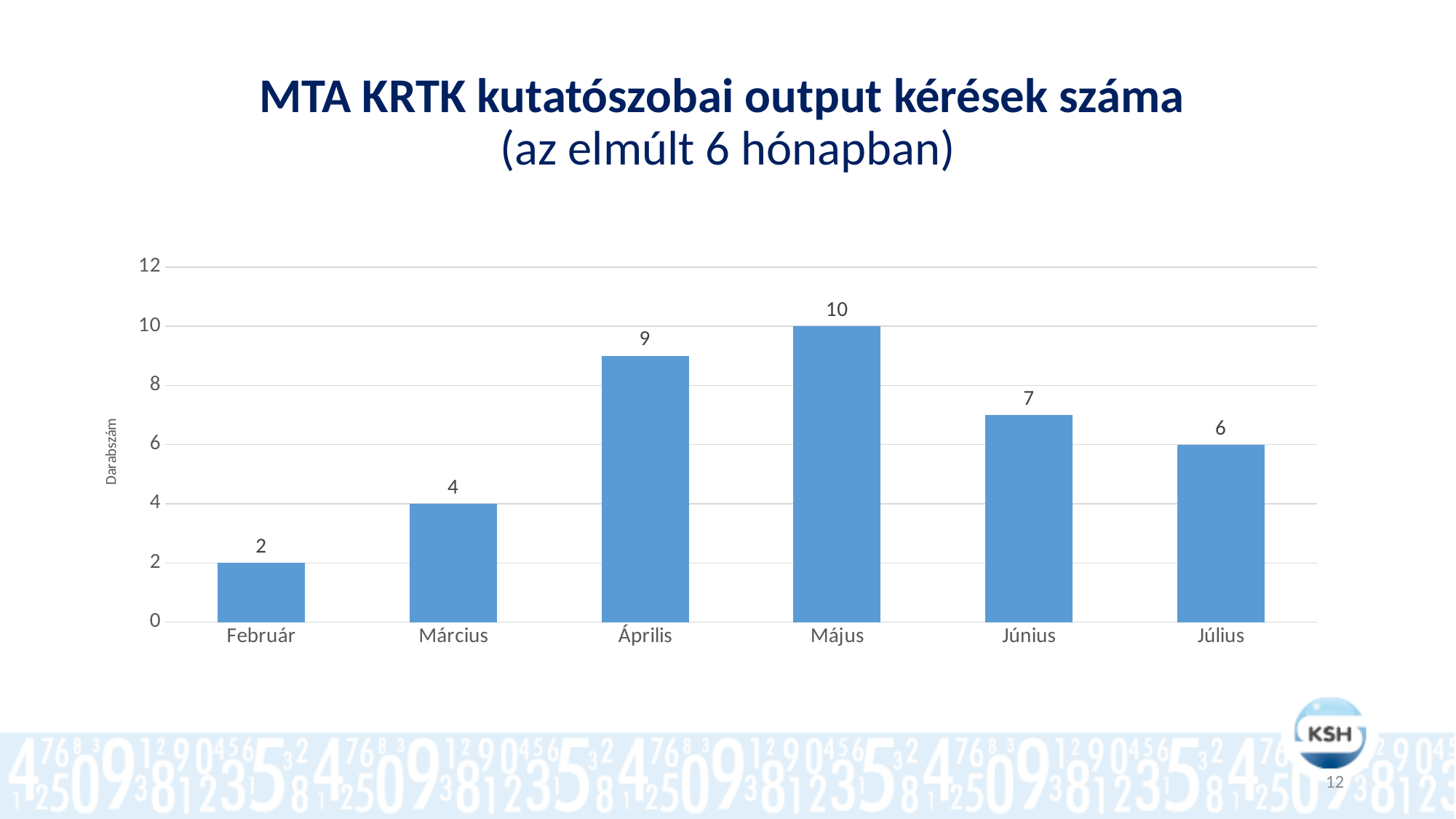
What is the difference between the values for Április and Július? 3 Which month has the lowest value? Február What is the value for Június? 7 Do the values rise or fall from Május to Július? fall Which month has the highest value? Május What is the value for Február? 2 What kind of chart is shown on the slide? bar chart How many months are shown on the x axis? 6 What is the value for Május? 10 What is the difference between the values for Május and Február? 8 What is the label of the vertical axis? Darabszám Which is larger, the value for Március or the value for Július? Július